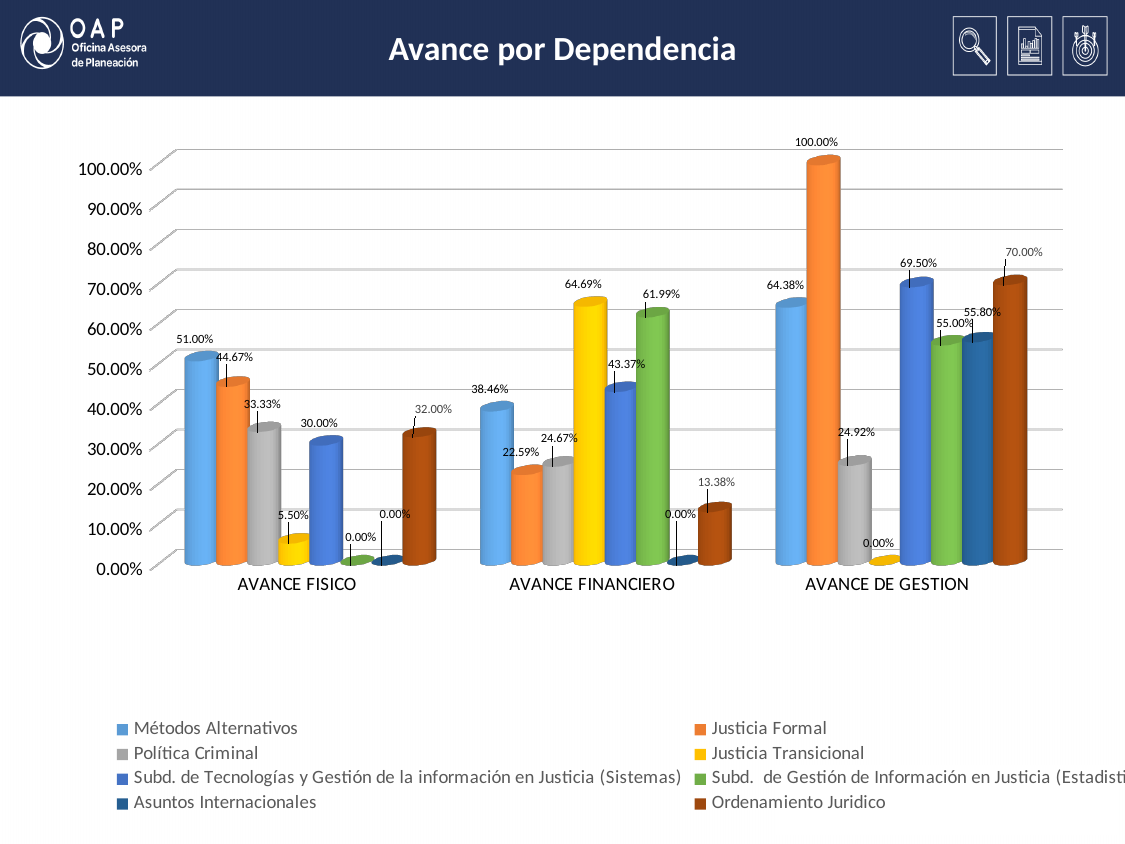
Which is larger in AVANCE FINANCIERO: Métodos Alternativos or Justicia Formal? Métodos Alternativos What is the title of the slide? Avance por Dependencia What is the value for Justicia Transicional in AVANCE FINANCIERO? 64.69% How many categories are shown on the x axis? 3 What is the difference between Justicia Formal and Métodos Alternativos in AVANCE DE GESTION? 35.62% What is the value for Métodos Alternativos in AVANCE FISICO? 51.00% Which series has the lowest value in AVANCE FINANCIERO? Asuntos Internacionales What is the value for Ordenamiento Juridico in AVANCE DE GESTION? 70.00% What type of chart is shown on the slide? Bar chart How many series does the legend list? 8 What is the value for Justicia Formal in AVANCE DE GESTION? 100.00% Which series has the highest value in AVANCE FISICO? Métodos Alternativos